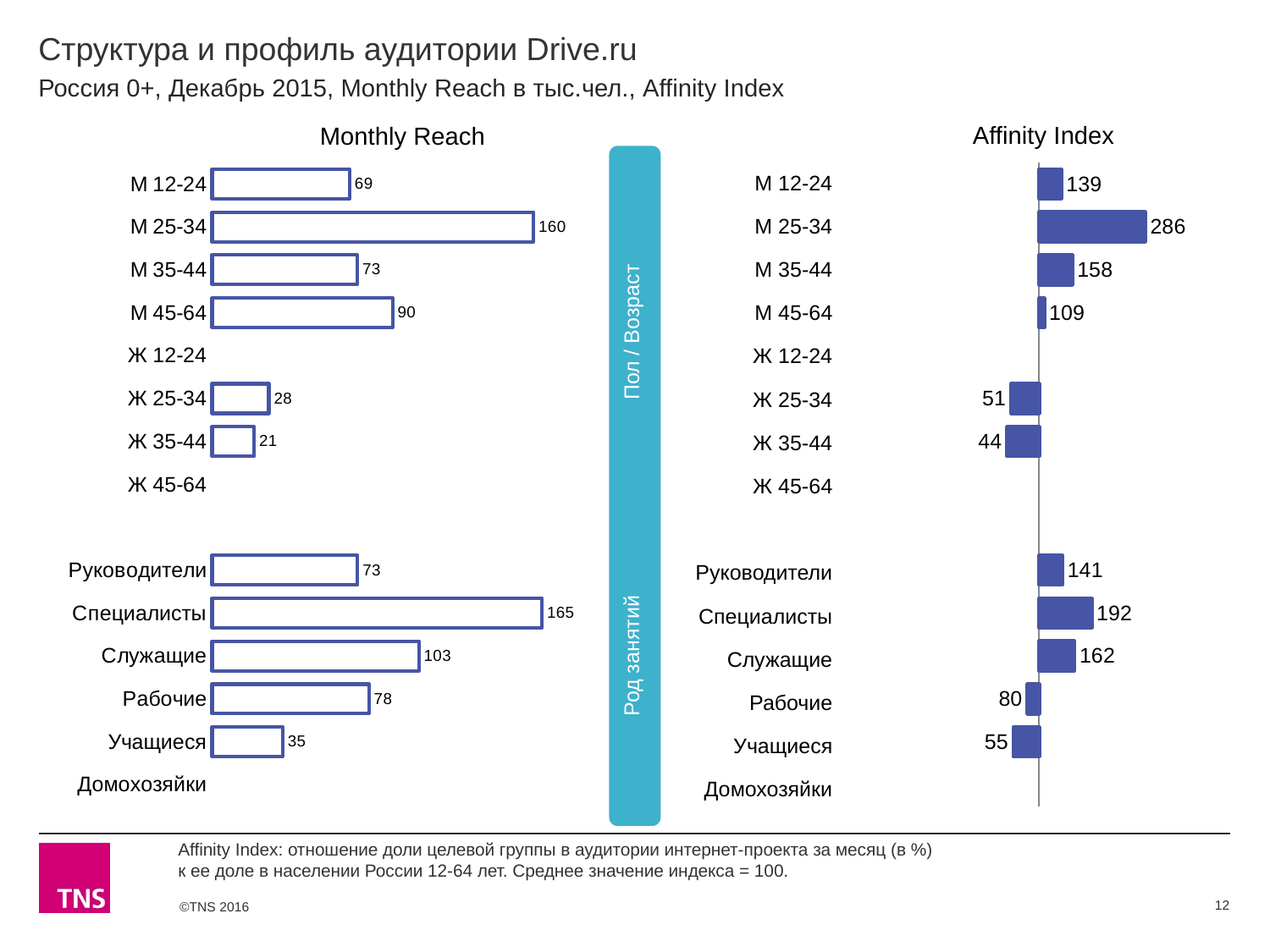
In the Monthly Reach chart, which is larger: М 45-64 or Рабочие? М 45-64 In the Affinity Index chart, which is larger: Служащие or М 35-44? Служащие In the Monthly Reach chart, what is the value for М 25-34? 160 In the Affinity Index chart, what is the value for Ж 25-34? 51 In the Affinity Index chart, what is the value for Учащиеся? 55 In the Monthly Reach chart, what is the difference between М 25-34 and М 12-24? 91 In the Affinity Index chart, what is the value for М 25-34? 286 In the Affinity Index chart, which category has the lowest labelled value? Ж 35-44 In the Monthly Reach chart, which category has the highest value? Специалисты In the Monthly Reach chart, what is the value for Служащие? 103 In the Affinity Index chart, what is the difference between Специалисты and Руководители? 51 What kind of chart is the Monthly Reach chart? Bar chart